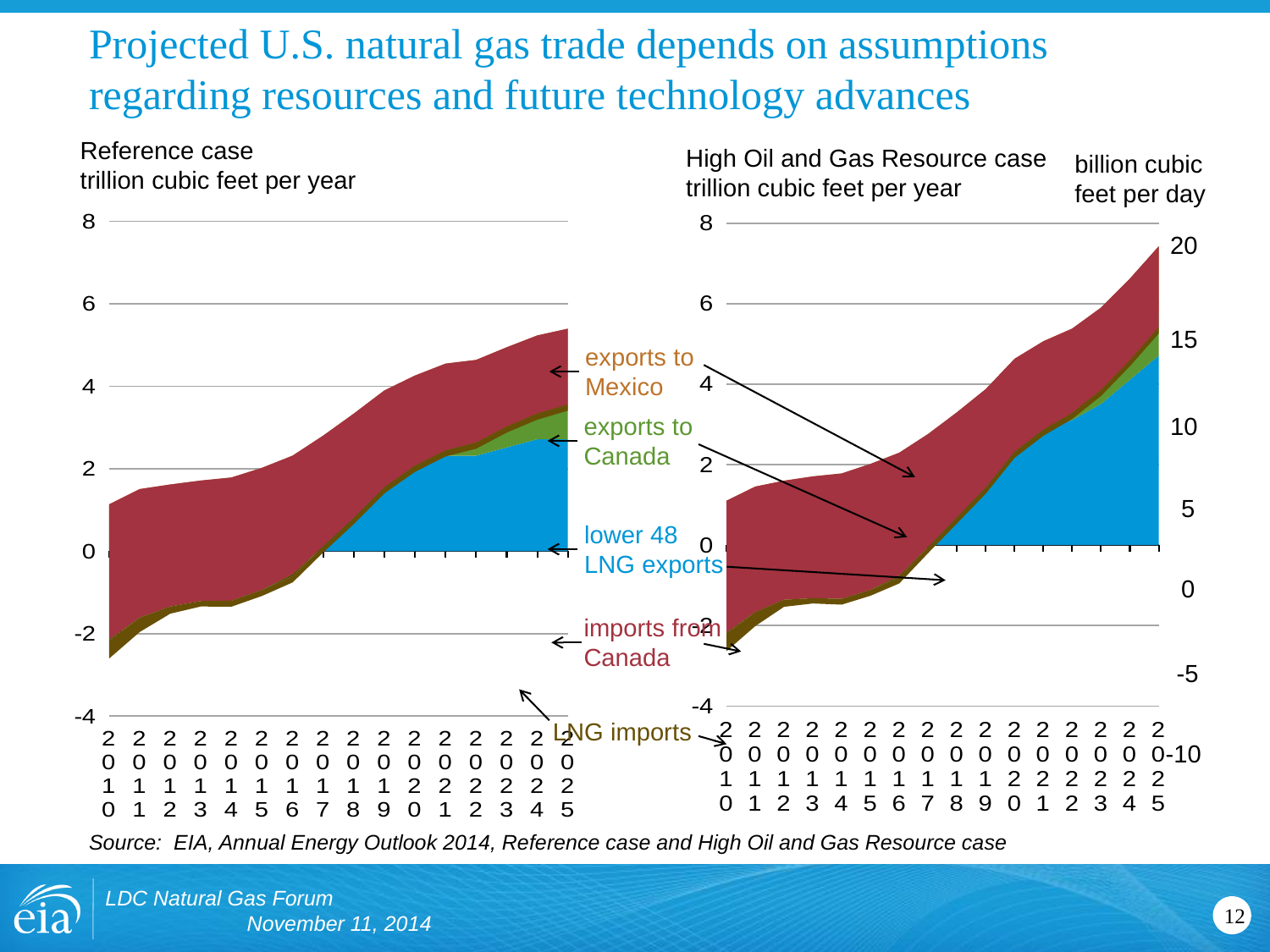
In the Reference case chart, is the value for lower 48 LNG exports in 2010 greater or less than 2? less How many years are shown on the x axis of the Reference case chart? 16 How many series are labelled on the slide's charts? 5 What is the first year shown on the x axis of the High Oil and Gas Resource case chart? 2010 In the High Oil and Gas Resource case chart, do total exports rise or fall from 2010 to 2025? rise In the Reference case chart, is the top of the stacked exports in 2025 greater or less than 4? greater Which chart shows higher total exports in 2025, the Reference case or the High Oil and Gas Resource case? High Oil and Gas Resource case What unit is shown on the right-hand axis of the High Oil and Gas Resource case chart? billion cubic feet per day What kind of chart is the Reference case chart? stacked area chart In the Reference case chart, is the bottom of the stacked imports in 2010 greater or less than -2? less